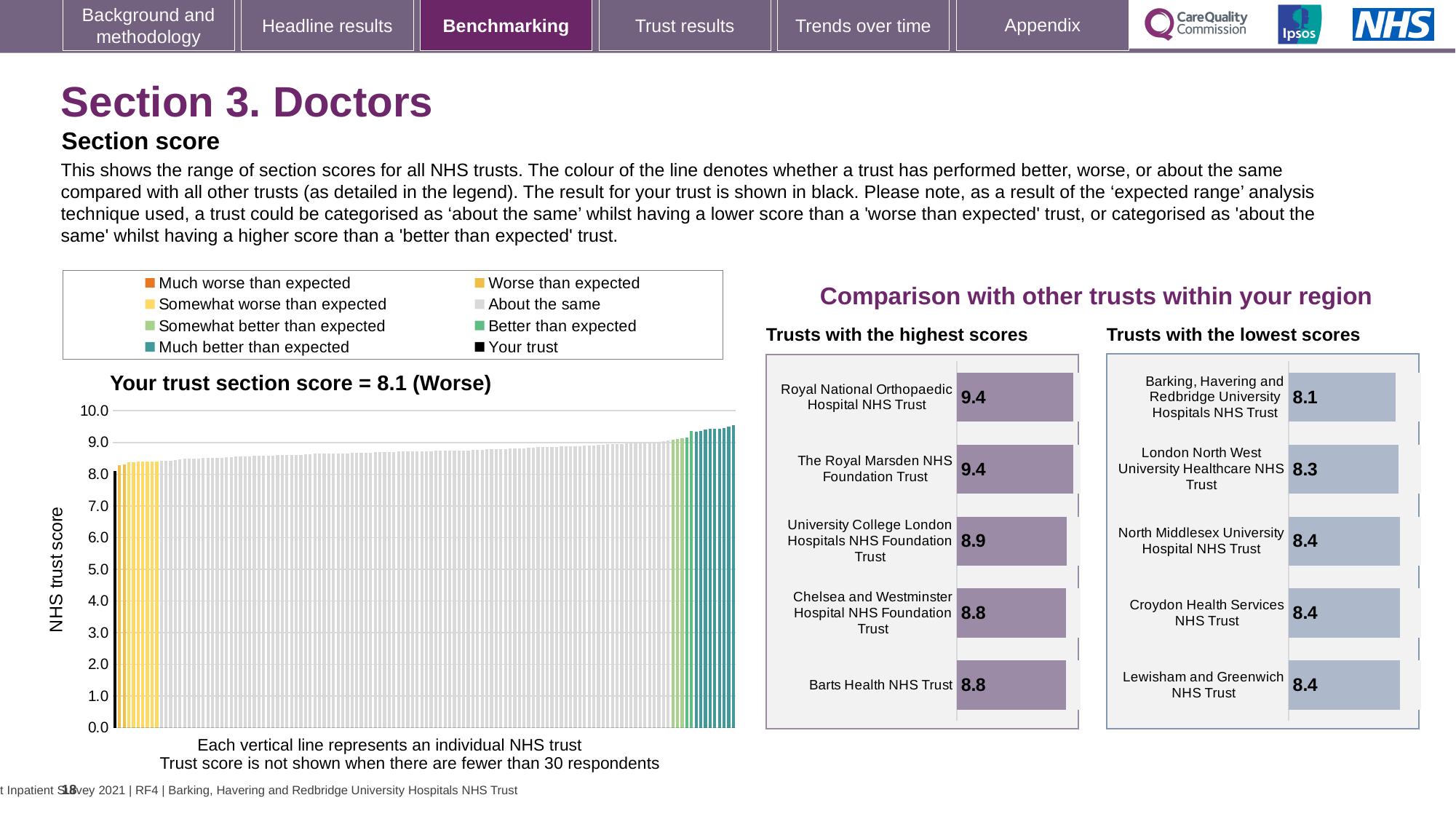
In the 'Trusts with the highest scores' chart, what is the score for University College London Hospitals NHS Foundation Trust? 8.9 What is your trust's section score shown in the title of the left-hand chart? 8.1 (Worse) In the 'Trusts with the lowest scores' chart, which trust has the lowest score? Barking, Havering and Redbridge University Hospitals NHS Trust In the 'Trusts with the lowest scores' chart, what is the difference between the score for Lewisham and Greenwich NHS Trust and the score for Barking, Havering and Redbridge University Hospitals NHS Trust? 0.3 In the left-hand chart of all NHS trusts, do the bar heights rise or fall from left to right along the x axis? rise In the 'Trusts with the highest scores' chart, what is the difference between the score for Royal National Orthopaedic Hospital NHS Trust and the score for Barts Health NHS Trust? 0.6 How many entries does the legend above the left-hand chart list? 8 How many trusts are listed in the 'Trusts with the lowest scores' chart? 5 In the left-hand chart of all NHS trusts, is the value of the tallest bar greater or less than 9.0? greater In the 'Trusts with the lowest scores' chart, what is the score for London North West University Healthcare NHS Trust? 8.3 In the 'Trusts with the highest scores' chart, which has the larger score: The Royal Marsden NHS Foundation Trust or Chelsea and Westminster Hospital NHS Foundation Trust? The Royal Marsden NHS Foundation Trust